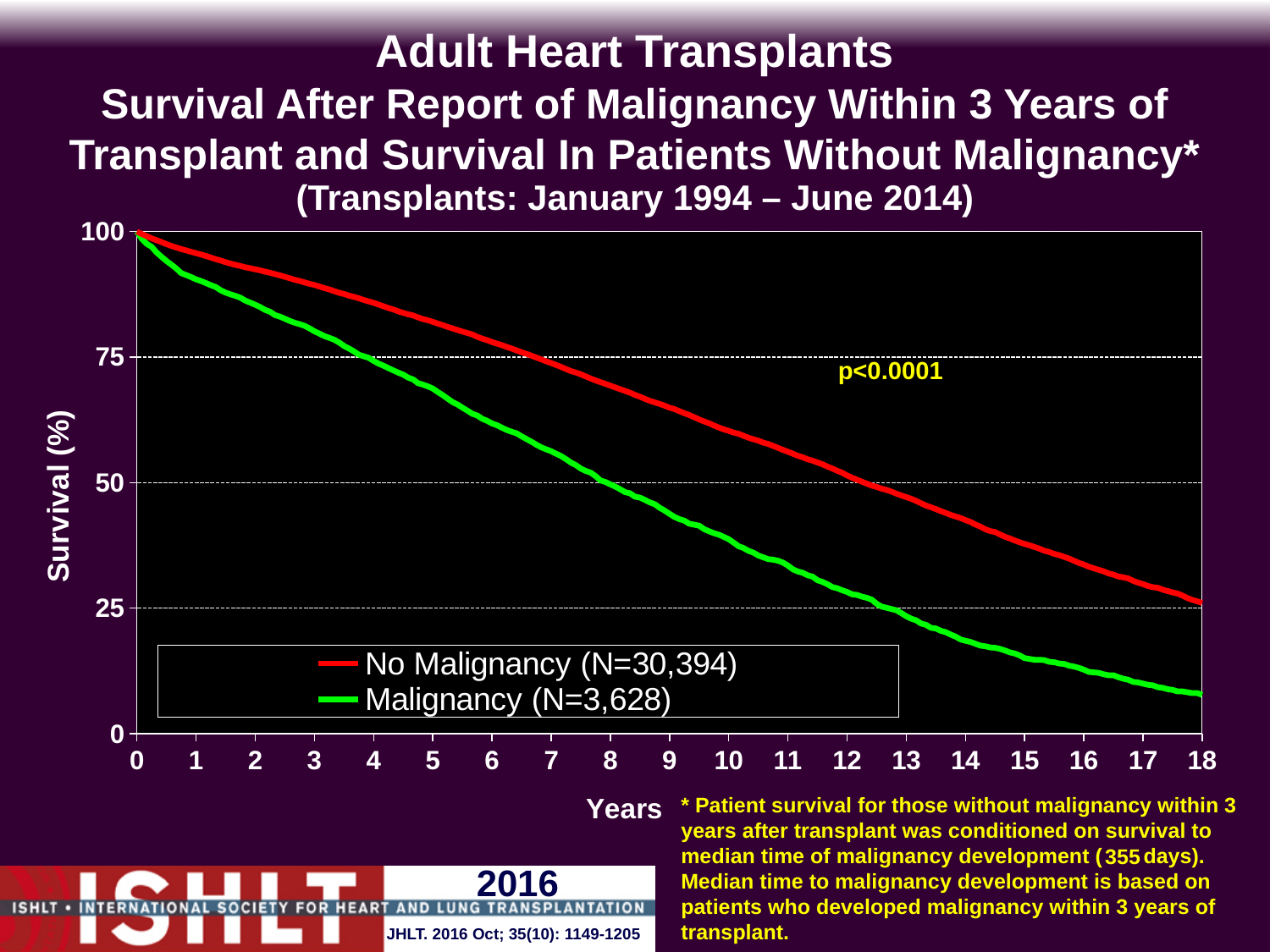
What is the p-value shown on the chart? p<0.0001 Is the survival value for the Malignancy series at 14 years greater or less than 25? less Is the survival value for the No Malignancy series at 5 years greater or less than 75? greater Is the survival value for the No Malignancy series at 16 years greater or less than 25? greater Which series is plotted in red? No Malignancy (N=30,394) Do the survival curves rise or fall as years increase? fall At 10 years, which series has higher survival: No Malignancy or Malignancy? No Malignancy How many series does the legend list? 2 What kind of chart is shown on the slide? line chart